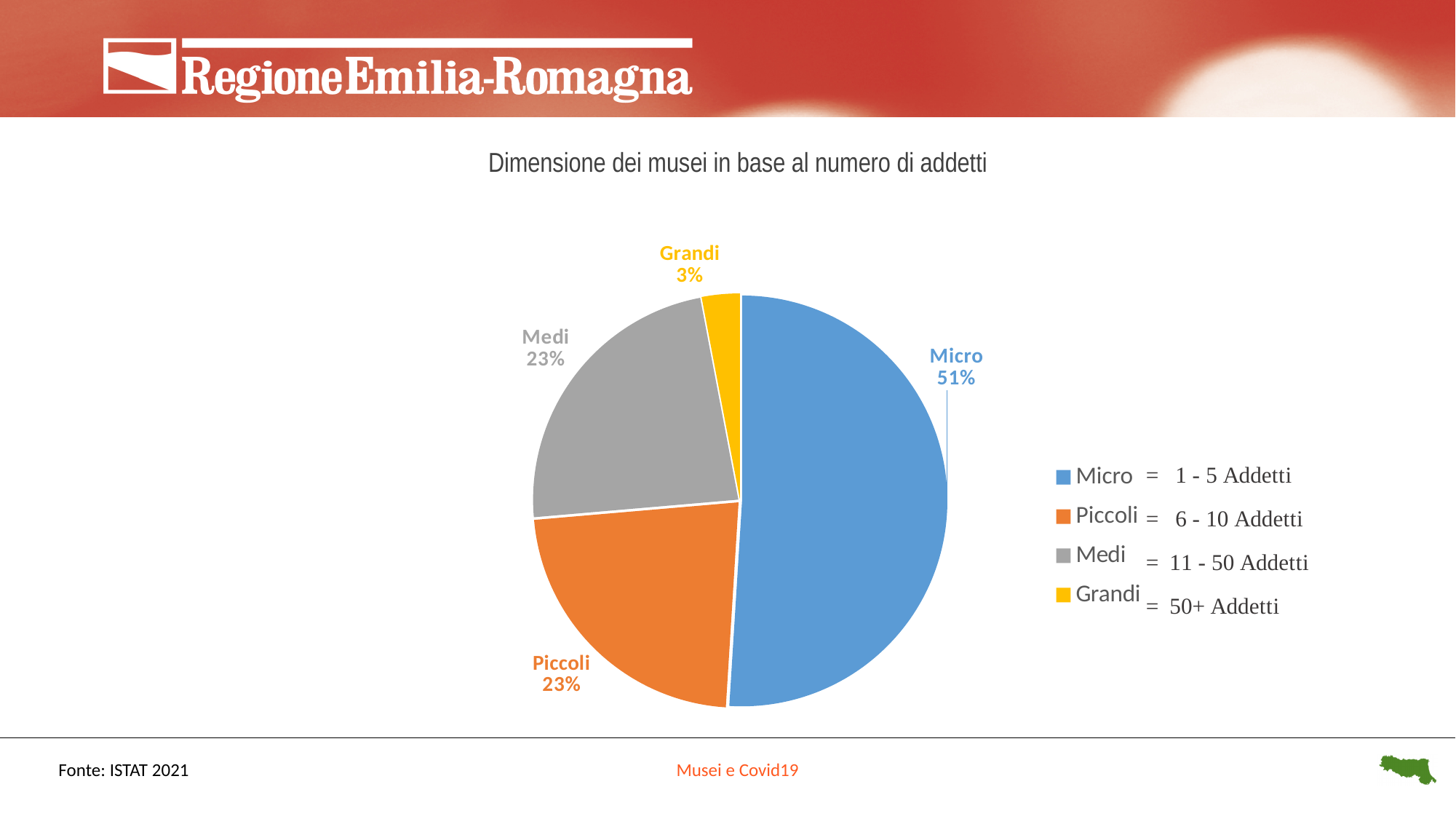
Which category has the largest slice of the pie? Micro What is the title of the chart? Dimensione dei musei in base al numero di addetti What share of the pie does the Grandi slice represent? 3% What share of the pie does the Micro slice represent? 51% How many slices does the pie chart have? 4 Which category has the smallest slice of the pie? Grandi What kind of chart is shown on the slide? pie chart What share of the pie does the Medi slice represent? 23% Which is larger, the Micro slice or the Medi slice? Micro What is the difference in percentage points between the Micro and Grandi slices? 48 According to the legend, how many employees (addetti) does the Medi category correspond to? 11 - 50 Addetti